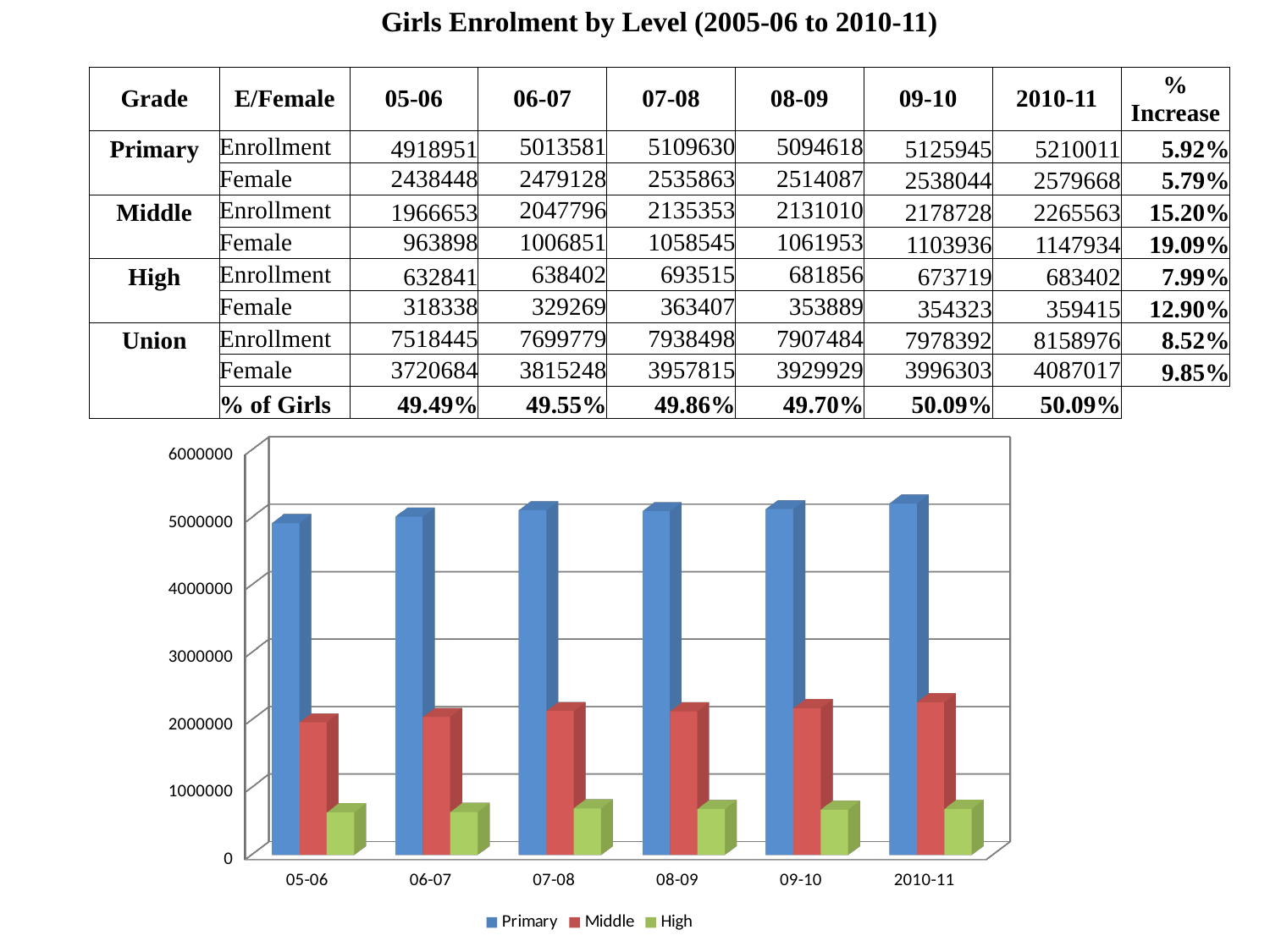
What kind of chart is shown on the slide? bar chart In 07-08, which is larger, the Primary bar or the Middle bar? Primary What colour are the Middle bars in the chart? red How many series does the chart's legend list? 3 Which series has the shortest bars in every year of the chart? High How many year categories are shown along the x axis of the chart? 6 Do the Middle bars overall rise or fall from 05-06 to 2010-11? rise Is the value for Primary in 05-06 greater or less than 4000000? greater Is the value for High in 2010-11 greater or less than 1000000? less Which series has the tallest bars in every year of the chart? Primary What is the difference between the Primary and Middle enrollment values for 2010-11, using the figures printed in the table? 2944448 What is the Primary enrollment value plotted for 2010-11, as printed in the table? 5210011